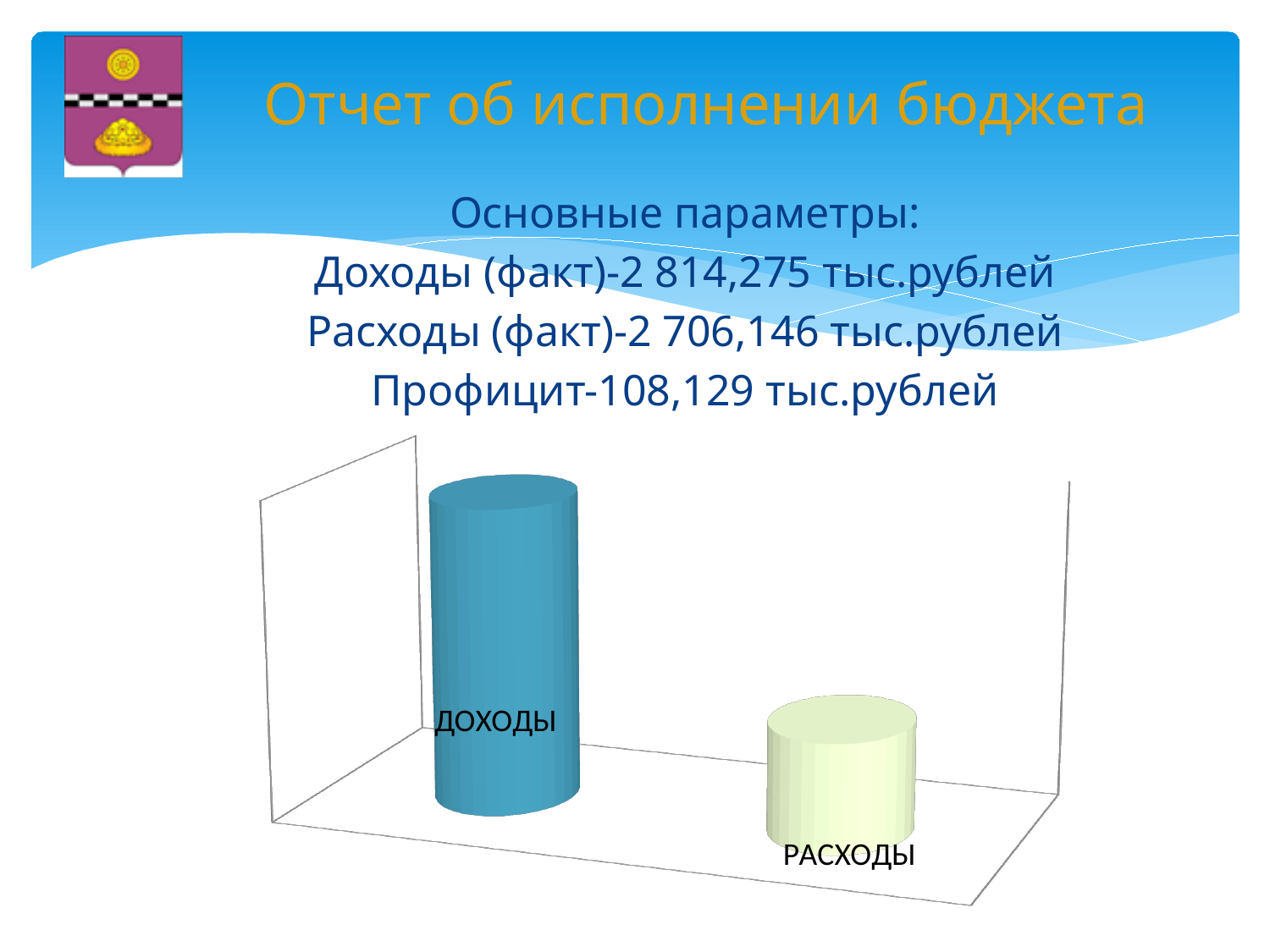
Which category has the tallest bar in the chart? ДОХОДЫ What are the labels of the two bars in the chart? ДОХОДЫ and РАСХОДЫ Which category has the shortest bar in the chart? РАСХОДЫ What colour is the ДОХОДЫ bar? blue What kind of chart is shown on the slide? bar chart Which bar is taller, ДОХОДЫ or РАСХОДЫ? ДОХОДЫ How many bars does the chart show? 2